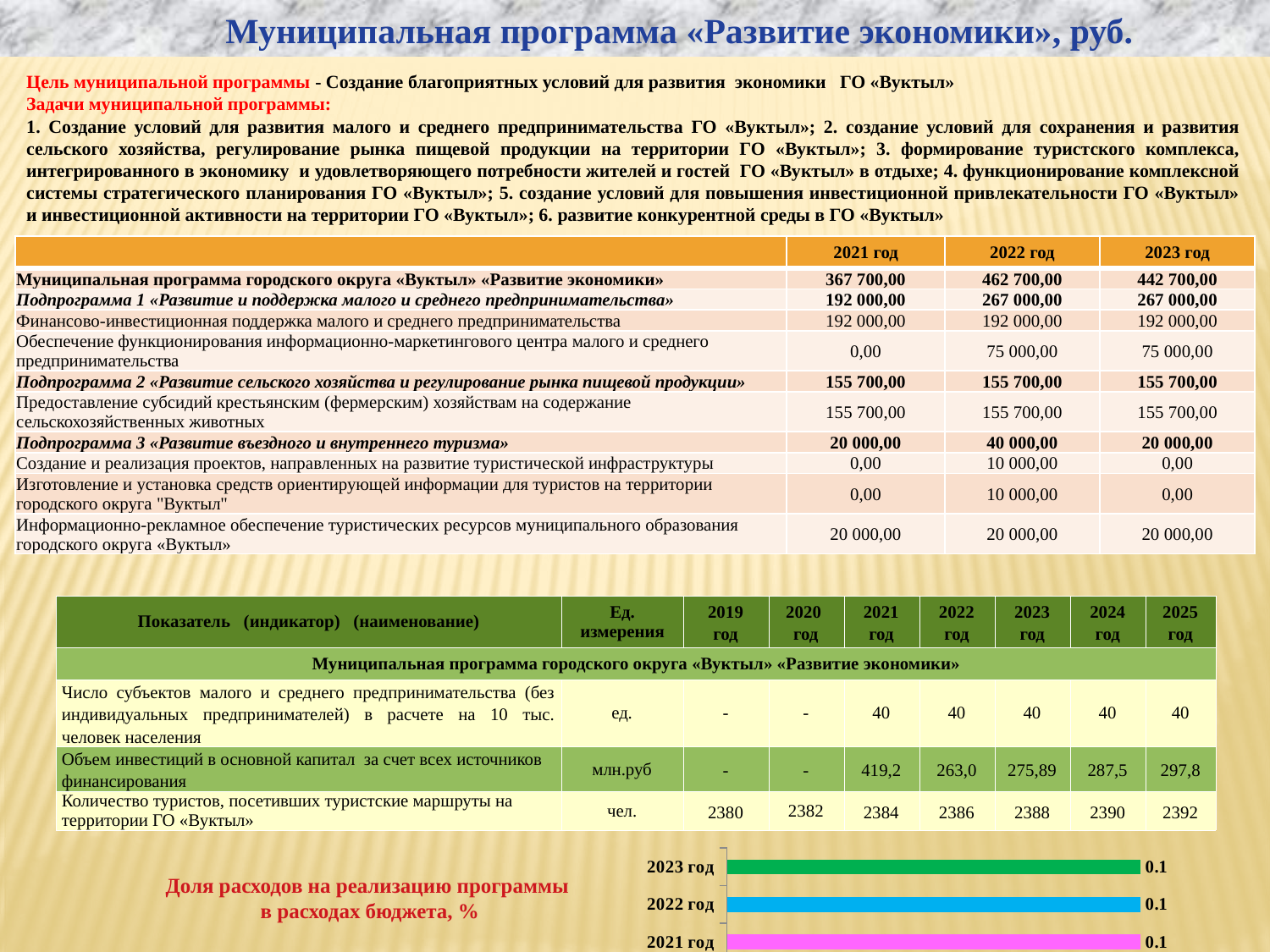
In the bar chart at the bottom of the slide, what is the value for 2021 год? 0.1 How many bars are plotted in the bar chart at the bottom of the slide? 3 In the bar chart at the bottom of the slide, what is the value for 2023 год? 0.1 What type of chart is shown at the bottom of the slide? bar chart What is the title of the bar chart at the bottom of the slide? Доля расходов на реализацию программы в расходах бюджета, % In the bar chart at the bottom of the slide, what colour is the bar for 2021 год? pink In the bar chart at the bottom of the slide, what is the difference between the values for 2023 год and 2021 год? 0 In the bar chart at the bottom of the slide, what is the value for 2022 год? 0.1 In the bar chart at the bottom of the slide, do the values rise, fall, or stay the same from 2021 год to 2023 год? stay the same